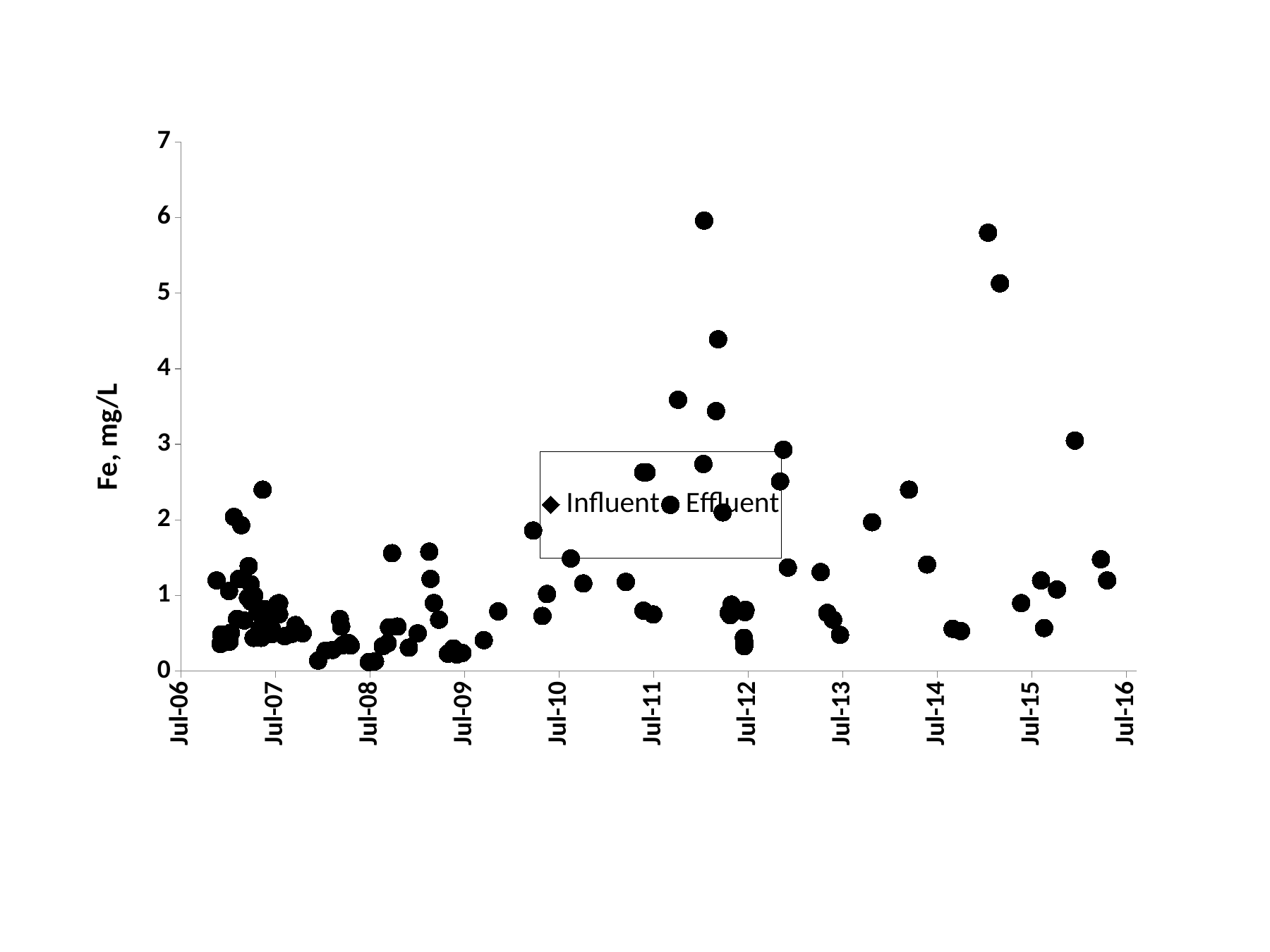
What are the two series named in the legend? Influent and Effluent What is the highest value shown on the vertical axis? 7 Is the highest Effluent value plotted between Jul-14 and Jul-15 greater or less than 5? greater Which marker shape does the legend use for the Effluent series? circle What kind of chart is shown on the slide? scatter chart Is the highest Effluent value plotted between Jul-06 and Jul-09 greater or less than 3? less What is the first date label on the horizontal axis? Jul-06 How many date labels are shown on the horizontal axis? 11 What is the last date label on the horizontal axis? Jul-16 Is the highest Effluent value plotted on the chart greater or less than 5? greater How many series does the legend list? 2 What is the label of the vertical axis? Fe, mg/L